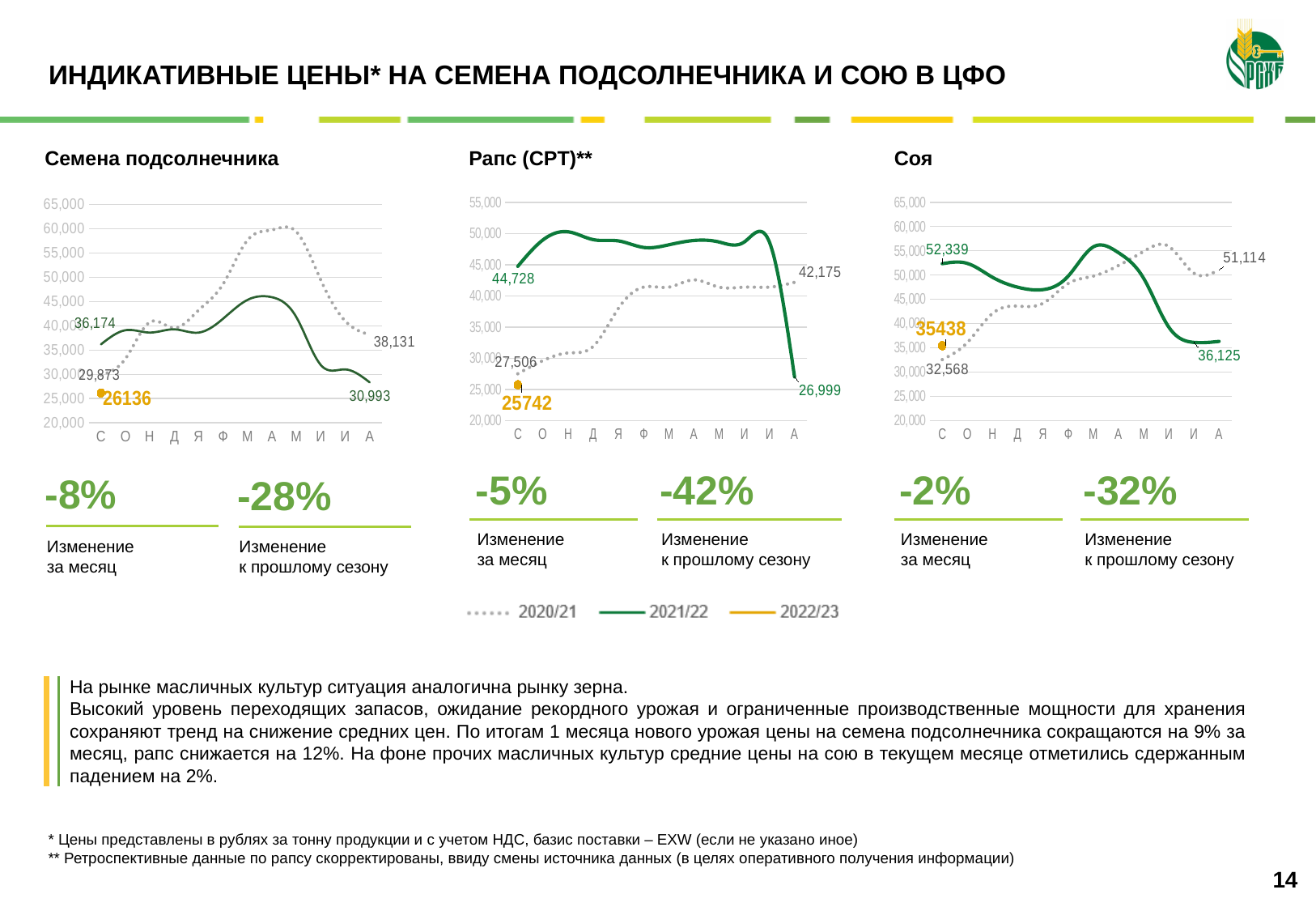
On the 'Семена подсолнечника' chart, what is the value of the 2022/23 series shown for September? 26136 On the 'Рапс (CPT)**' chart, what is the last labelled value of the 2020/21 series? 42,175 On the 'Рапс (CPT)**' chart, what is the last labelled value of the 2021/22 series? 26,999 On the 'Соя' chart, what is the difference between the first labelled value of the 2021/22 series (52,339) and its last labelled value (36,125)? 16,214 On the 'Рапс (CPT)**' chart, is the peak of the 2021/22 series greater or less than 45,000? greater On the 'Соя' chart, what is the value of the 2022/23 series shown for September? 35438 On the 'Рапс (CPT)**' chart, which is larger: the last labelled value of the 2020/21 series or the last labelled value of the 2021/22 series? 2020/21 (42,175) How many series does the legend list for the charts? 3 On the 'Семена подсолнечника' chart, what is the first labelled value of the 2021/22 series? 36,174 On the 'Семена подсолнечника' chart, what is the last labelled value of the 2021/22 series? 30,993 What kind of chart is the 'Семена подсолнечника' chart? Line chart On the 'Соя' chart, what is the first labelled value of the 2021/22 series? 52,339